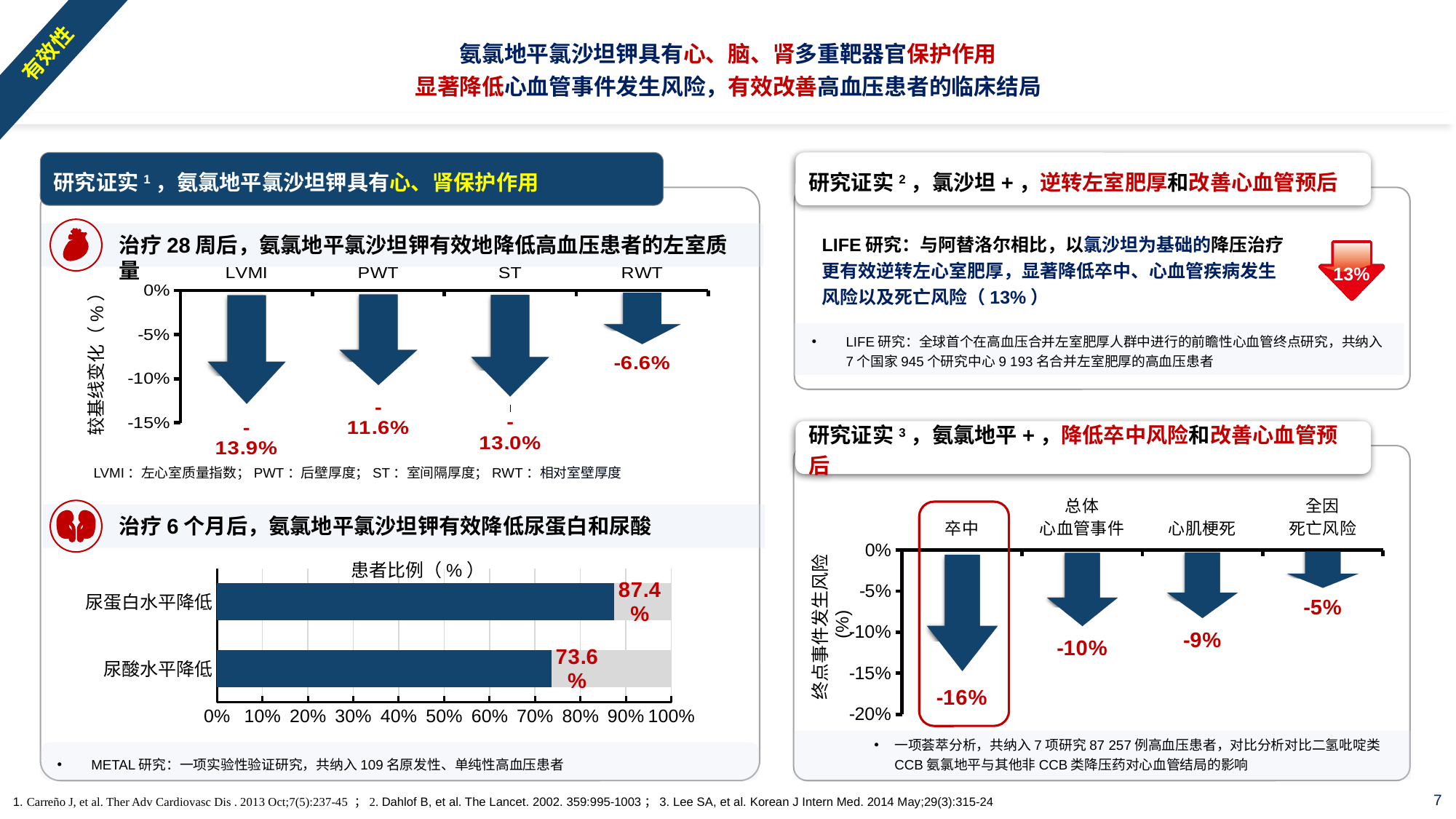
In the top-left chart (左室质量 change from baseline), how many categories are shown? 4 In the top-left chart (左室质量 change from baseline), what is the value for RWT? -6.6% In the top-left chart (左室质量 change from baseline), which category shows the smallest reduction? RWT In the bottom-left bar chart (患者比例), what is the value for 尿蛋白水平降低? 87.4% In the bottom-right chart (终点事件发生风险), what is the value for 卒中? -16% In the bottom-left bar chart (患者比例), what is the value for 尿酸水平降低? 73.6% In the bottom-left bar chart (患者比例), what is the difference between 尿蛋白水平降低 and 尿酸水平降低? 13.8% In the bottom-right chart (终点事件发生风险), which category shows the largest risk reduction? 卒中 In the top-left chart (左室质量 change from baseline), what is the value for LVMI? -13.9% In the top-left chart (左室质量 change from baseline), which category shows the largest reduction? LVMI In the bottom-right chart (终点事件发生风险), what is the value for 心肌梗死? -9% What kind of chart is the bottom-left chart (患者比例)? bar chart